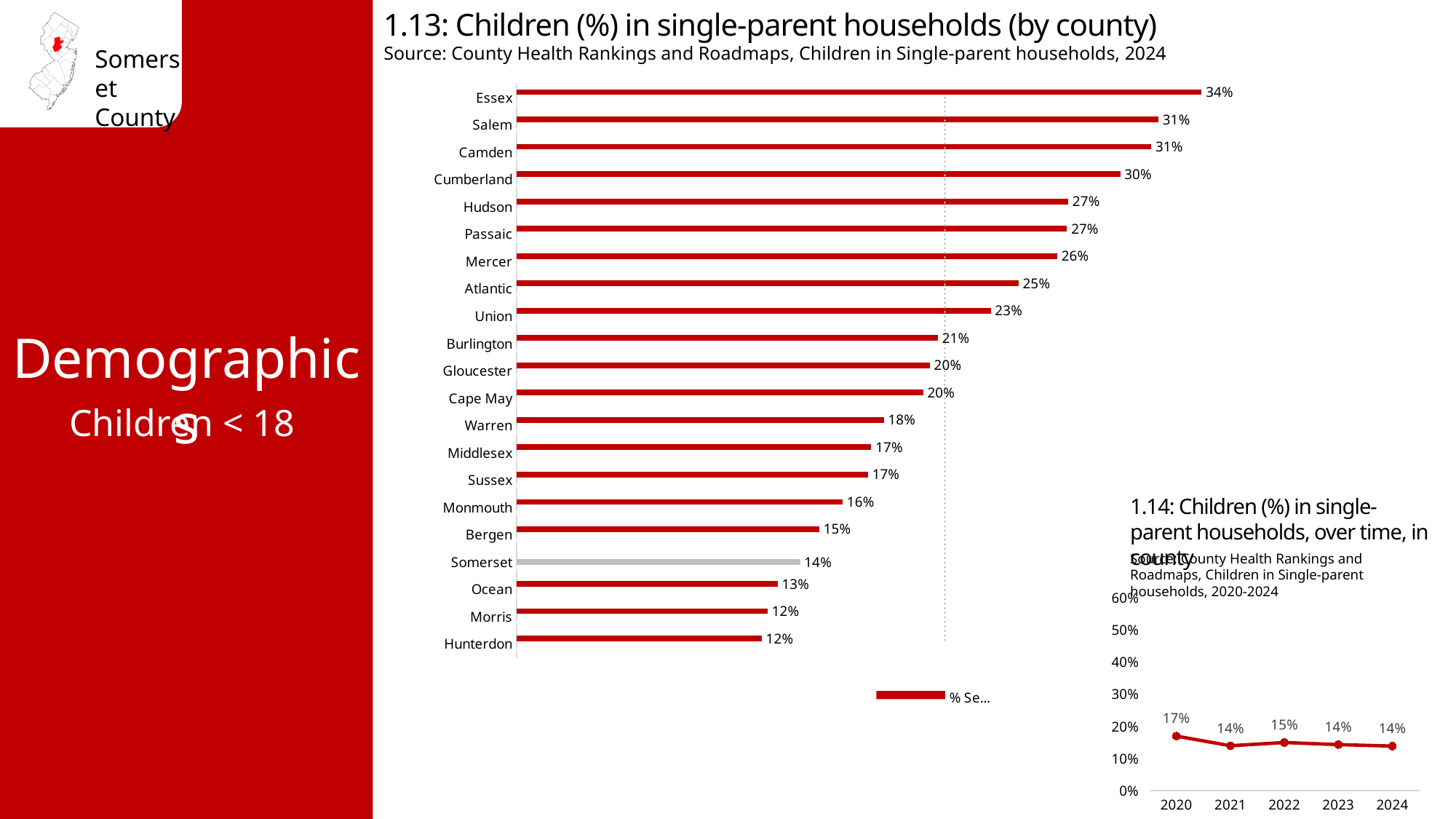
In chart 1.14, how many years are plotted? 5 In chart 1.13, what is the value for Cumberland? 30% In chart 1.14 (children in single-parent households over time), what is the value for 2020? 17% In chart 1.13, what is the value for Hudson? 27% In chart 1.13, which county has the highest percentage of children in single-parent households? Essex In chart 1.13, how many counties are shown? 21 In chart 1.13, what is the difference between the values for Essex and Somerset? 20 percentage points In chart 1.14, which year has the highest value? 2020 In chart 1.13 (children in single-parent households by county), what is the value for Somerset? 14% In chart 1.13, which county has a larger value, Union or Bergen? Union In chart 1.14, what is the value for 2024? 14% What kind of chart is chart 1.13? Bar chart